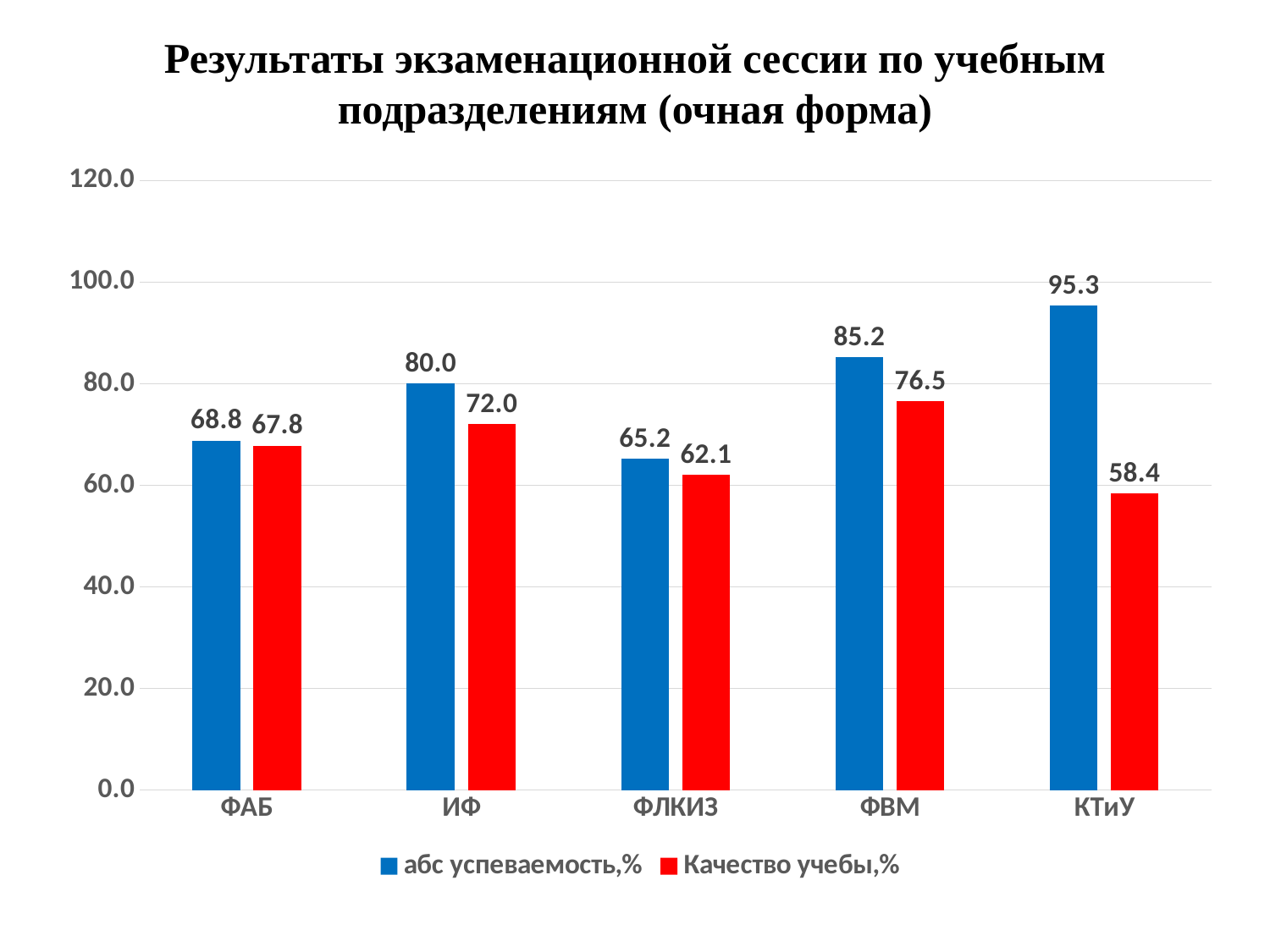
What is the difference between абс успеваемость,% and Качество учебы,% for КТиУ? 36.9 What is the value of абс успеваемость,% for КТиУ? 95.3 Which colour represents Качество учебы,% in the chart? Red Which is larger for ИФ: абс успеваемость,% or Качество учебы,%? абс успеваемость,% What is the value of Качество учебы,% for ФЛКИЗ? 62.1 What is the value of Качество учебы,% for ФВМ? 76.5 How many categories are shown on the x axis? 5 Which category has the lowest абс успеваемость,%? ФЛКИЗ What kind of chart is shown on the slide? Bar chart Which category has the lowest Качество учебы,%? КТиУ How many series does the legend list? 2 Which category has the highest абс успеваемость,%? КТиУ